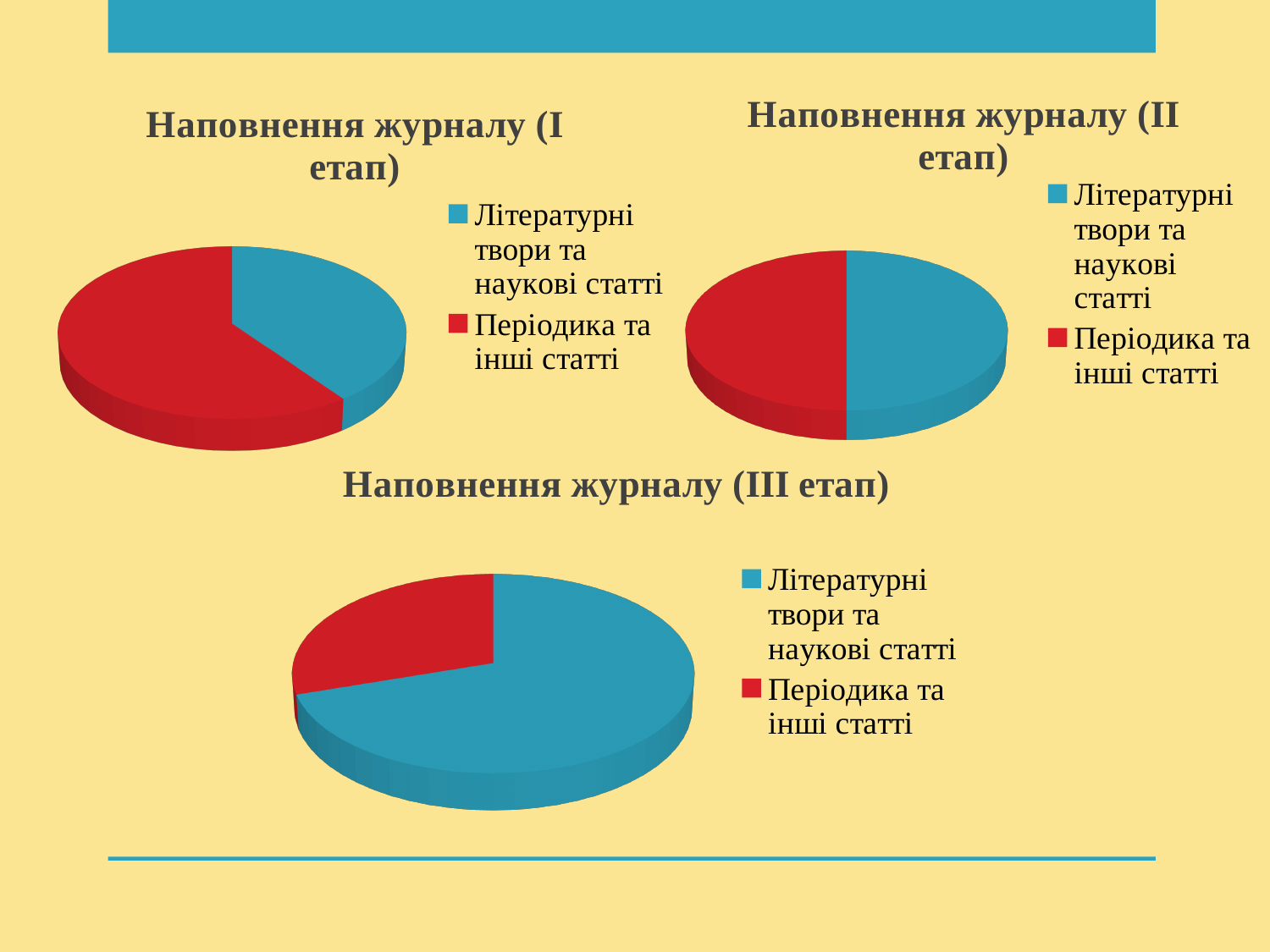
In "Наповнення журналу (III етап)", which category has the smallest slice? Періодика та інші статті How many slices does the pie chart "Наповнення журналу (II етап)" have? 2 In "Наповнення журналу (III етап)", which is larger: "Літературні твори та наукові статті" or "Періодика та інші статті"? Літературні твори та наукові статті What kind of chart is "Наповнення журналу (I етап)"? pie chart How many pie charts are shown on the slide? 3 In "Наповнення журналу (I етап)", which category has the smallest slice? Літературні твори та наукові статті In "Наповнення журналу (I етап)", which category has the largest slice? Періодика та інші статті In "Наповнення журналу (III етап)", which category has the largest slice? Літературні твори та наукові статті How many series does the legend of "Наповнення журналу (III етап)" list? 2 What is the title of the chart at the bottom of the slide? Наповнення журналу (III етап) What colour represents "Періодика та інші статті" in the charts on the slide? red In "Наповнення журналу (I етап)", which is larger: "Літературні твори та наукові статті" or "Періодика та інші статті"? Періодика та інші статті